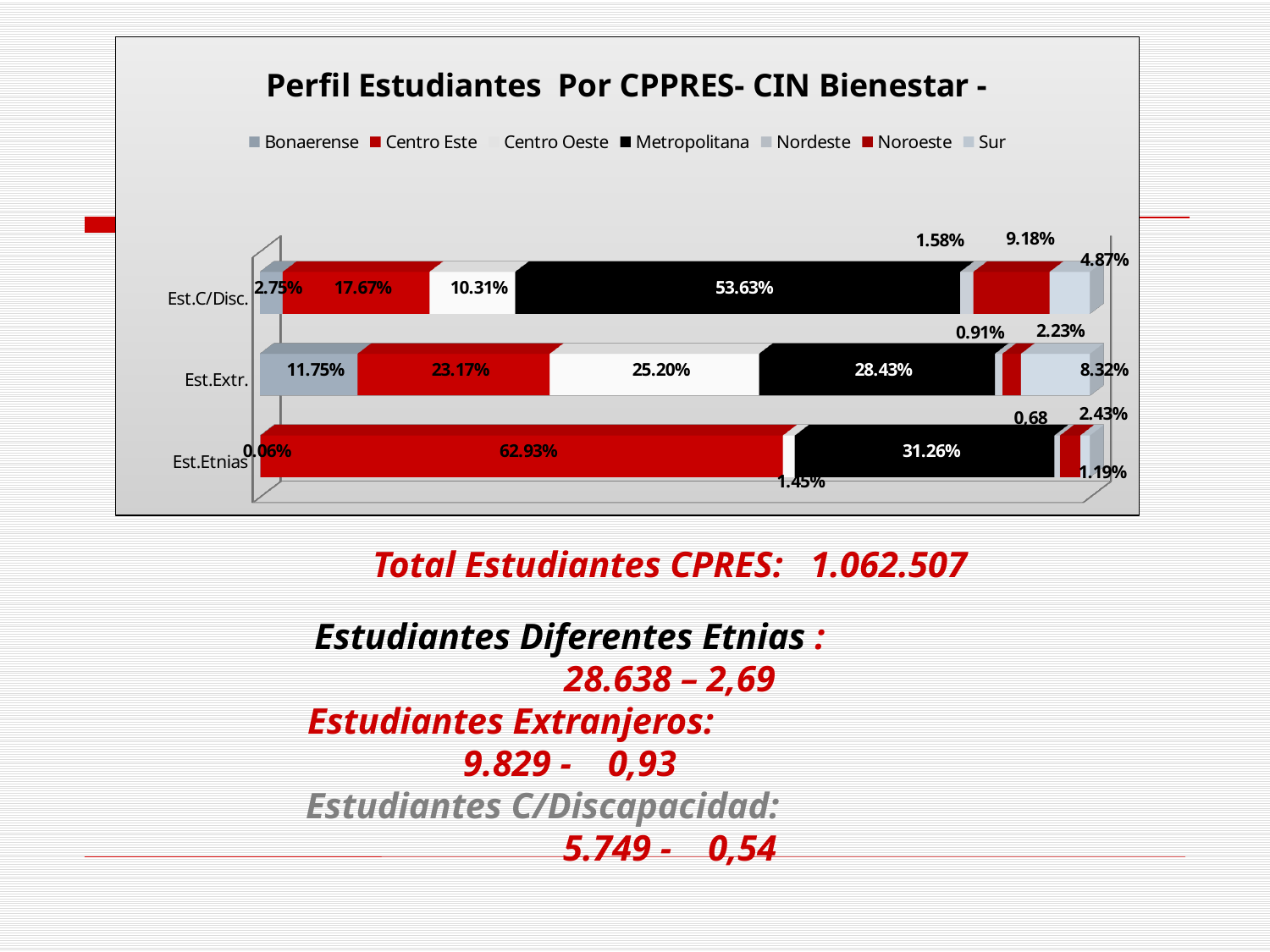
How many series does the legend list? 7 What is the Metropolitana value for Est.C/Disc.? 53.63% Which series has the largest share in the Est.Extr. bar? Metropolitana What is the Centro Oeste value for Est.Extr.? 25.20% How many categories are plotted on the chart? 3 What is the title of the chart? Perfil Estudiantes Por CPPRES- CIN Bienestar - Which series has the smallest share in the Est.Etnias bar? Bonaerense What is the Bonaerense value for Est.Extr.? 11.75% What is the difference between the Centro Este value for Est.Etnias and the Metropolitana value for Est.Etnias? 31.67% What kind of chart is shown on the slide? stacked bar chart Which is larger for Est.C/Disc.: Centro Este or Centro Oeste? Centro Este What is the Centro Este value for Est.Etnias? 62.93%